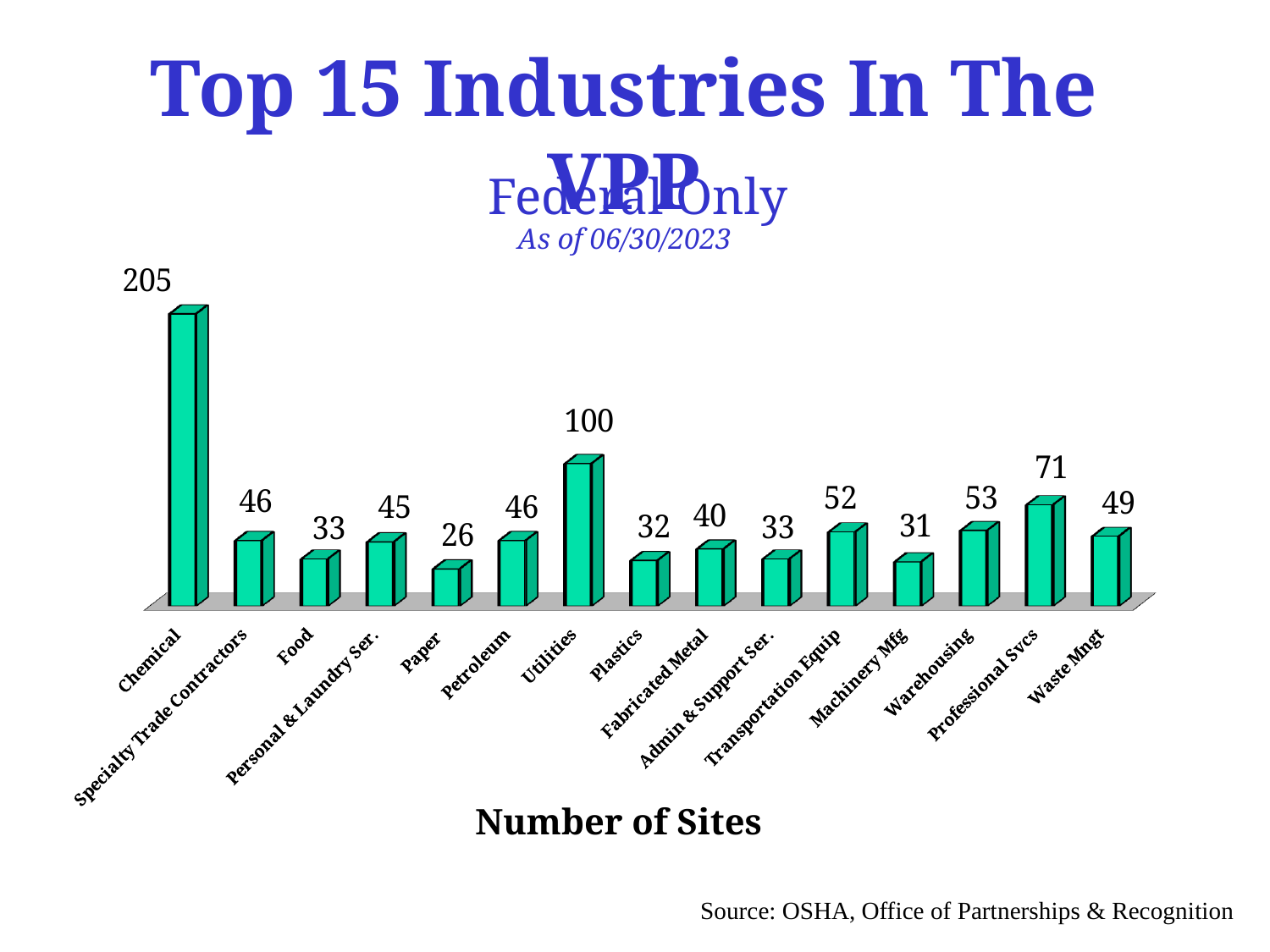
How many industries are shown in the chart? 15 Which industry has the lowest number of sites? Paper What is the number of sites for Professional Svcs? 71 Which industry has the highest number of sites? Chemical What type of chart is shown on the slide? Bar chart What is the difference in number of sites between Professional Svcs and Warehousing? 18 Which has more sites, Fabricated Metal or Plastics? Fabricated Metal What is the label on the horizontal axis of the chart? Number of Sites Which has more sites, Transportation Equip or Waste Mngt? Transportation Equip What is the difference in number of sites between Chemical and Utilities? 105 What is the number of sites for Utilities? 100 How many sites does the Chemical industry have? 205